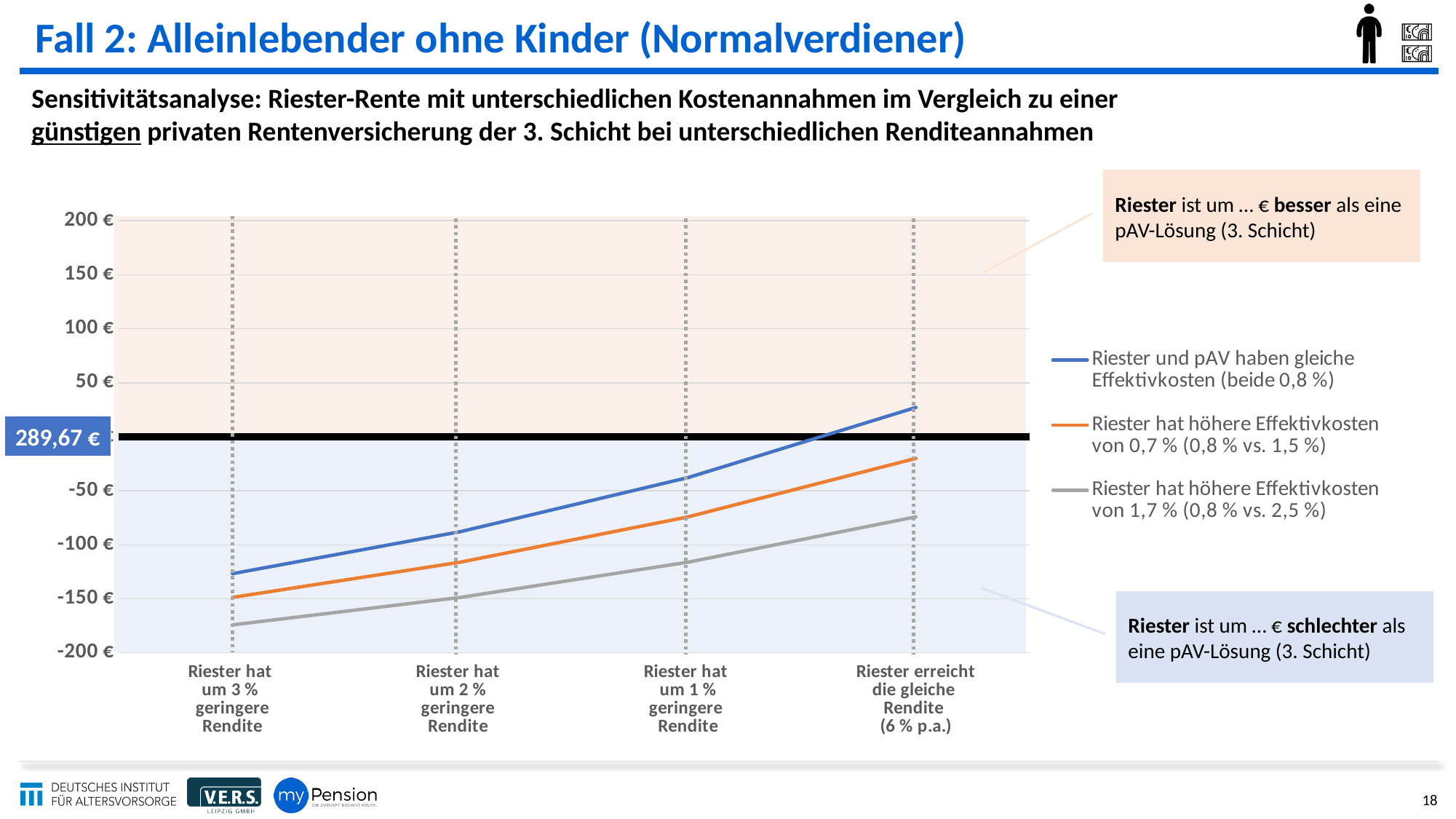
How many categories are shown along the x axis of the chart? 4 Is the value of the series 'Riester und pAV haben gleiche Effektivkosten (beide 0,8 %)' at 'Riester hat um 3 % geringere Rendite' greater or less than -100 €? less How many series does the chart legend list? 3 What kind of chart is shown on the slide? line chart Which series has the highest value at 'Riester erreicht die gleiche Rendite (6 % p.a.)'? Riester und pAV haben gleiche Effektivkosten (beide 0,8 %) What value is printed on the label attached to the horizontal black line in the chart? 289,67 € Is the value of the series 'Riester hat höhere Effektivkosten von 0,7 % (0,8 % vs. 1,5 %)' at 'Riester hat um 1 % geringere Rendite' greater or less than -100 €? greater Is the value of the series 'Riester und pAV haben gleiche Effektivkosten (beide 0,8 %)' at 'Riester erreicht die gleiche Rendite (6 % p.a.)' greater or less than 0 €? greater At 'Riester hat um 2 % geringere Rendite', which is larger: the value of 'Riester und pAV haben gleiche Effektivkosten (beide 0,8 %)' or the value of 'Riester hat höhere Effektivkosten von 1,7 % (0,8 % vs. 2,5 %)'? Riester und pAV haben gleiche Effektivkosten (beide 0,8 %) Do the values of the series 'Riester und pAV haben gleiche Effektivkosten (beide 0,8 %)' rise or fall from left to right along the x axis? rise Which series has the lowest value at 'Riester hat um 3 % geringere Rendite'? Riester hat höhere Effektivkosten von 1,7 % (0,8 % vs. 2,5 %)